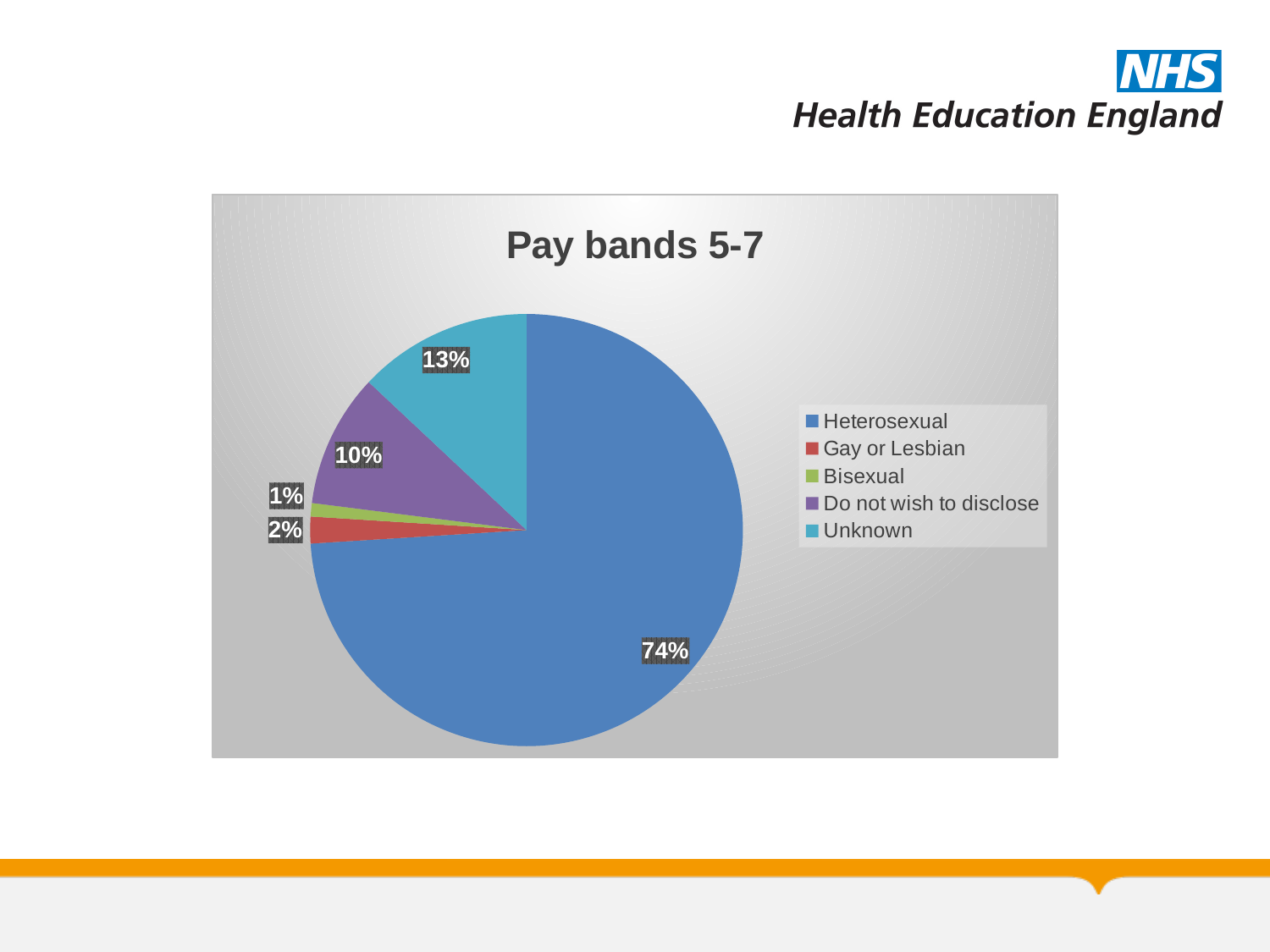
What percentage of the pie is Bisexual? 1% How many categories does the legend list? 5 What percentage of the pie is Heterosexual? 74% Which category has the smallest share of the pie? Bisexual Which is larger, the share for Gay or Lesbian or the share for Bisexual? Gay or Lesbian Which category has the largest share of the pie? Heterosexual What percentage of the pie is Gay or Lesbian? 2% What percentage of the pie is Unknown? 13% What percentage of the pie is Do not wish to disclose? 10% What is the title of the chart? Pay bands 5-7 What is the difference in percentage points between Unknown and Do not wish to disclose? 3 What type of chart is shown on the slide? Pie chart